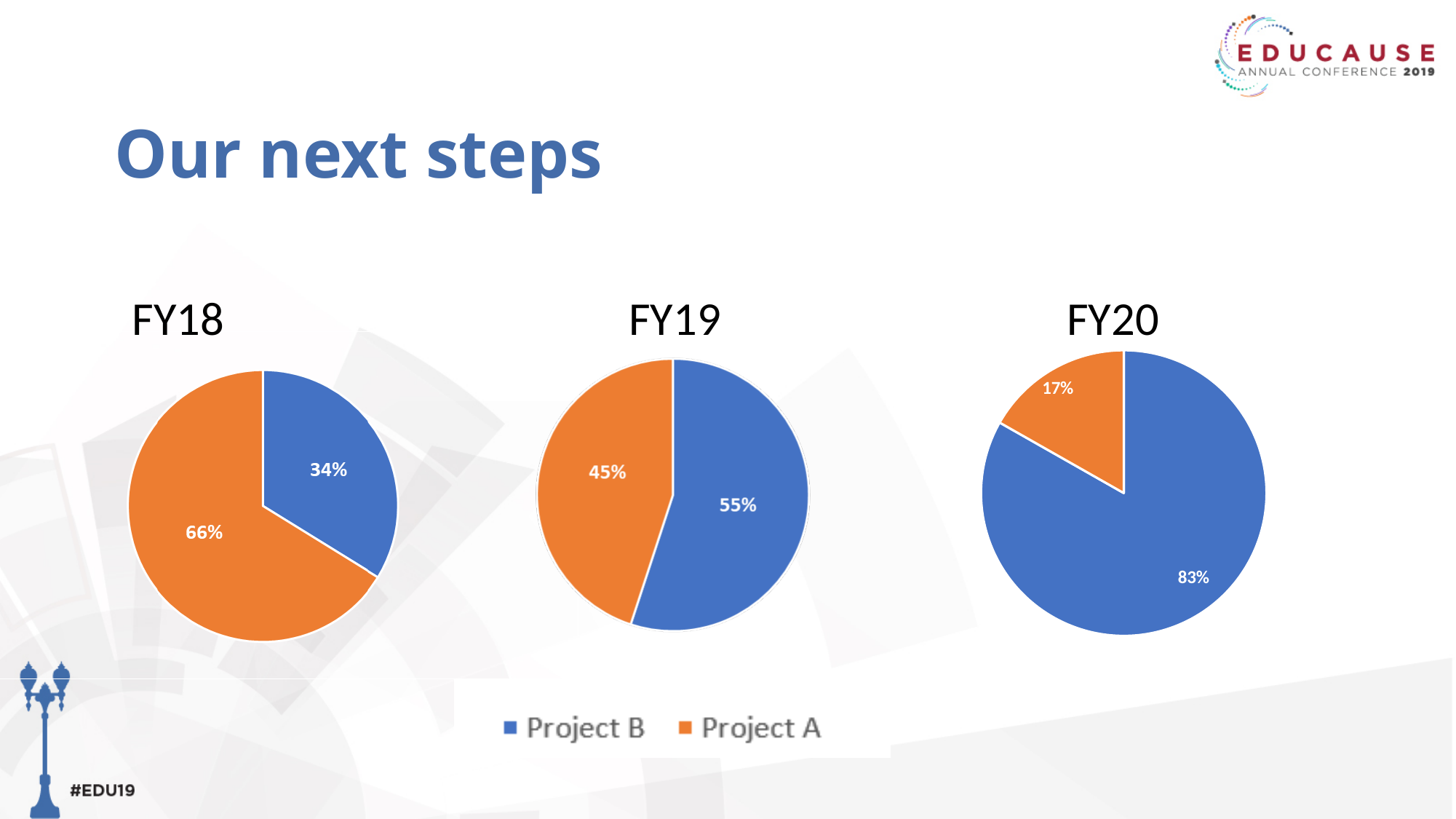
In the FY20 pie chart, which project has the smaller slice? Project A Across the FY18, FY19 and FY20 pie charts, does the Project B share rise or fall from FY18 to FY20? rise In the FY18 pie chart, which project has the larger slice? Project A How many series does the legend list? 2 In the FY19 pie chart, what share does Project B have? 55% In the FY18 pie chart, what share does Project A have? 66% In the FY20 pie chart, what share does Project A have? 17% What kind of chart is used for FY18, FY19 and FY20? Pie chart In the FY18 pie chart, what share does Project B have? 34% In the FY19 pie chart, what is the difference between the Project B and Project A shares? 10% In the FY20 pie chart, what share does Project B have? 83% In the FY20 pie chart, is the Project B share larger or smaller than the Project A share? larger